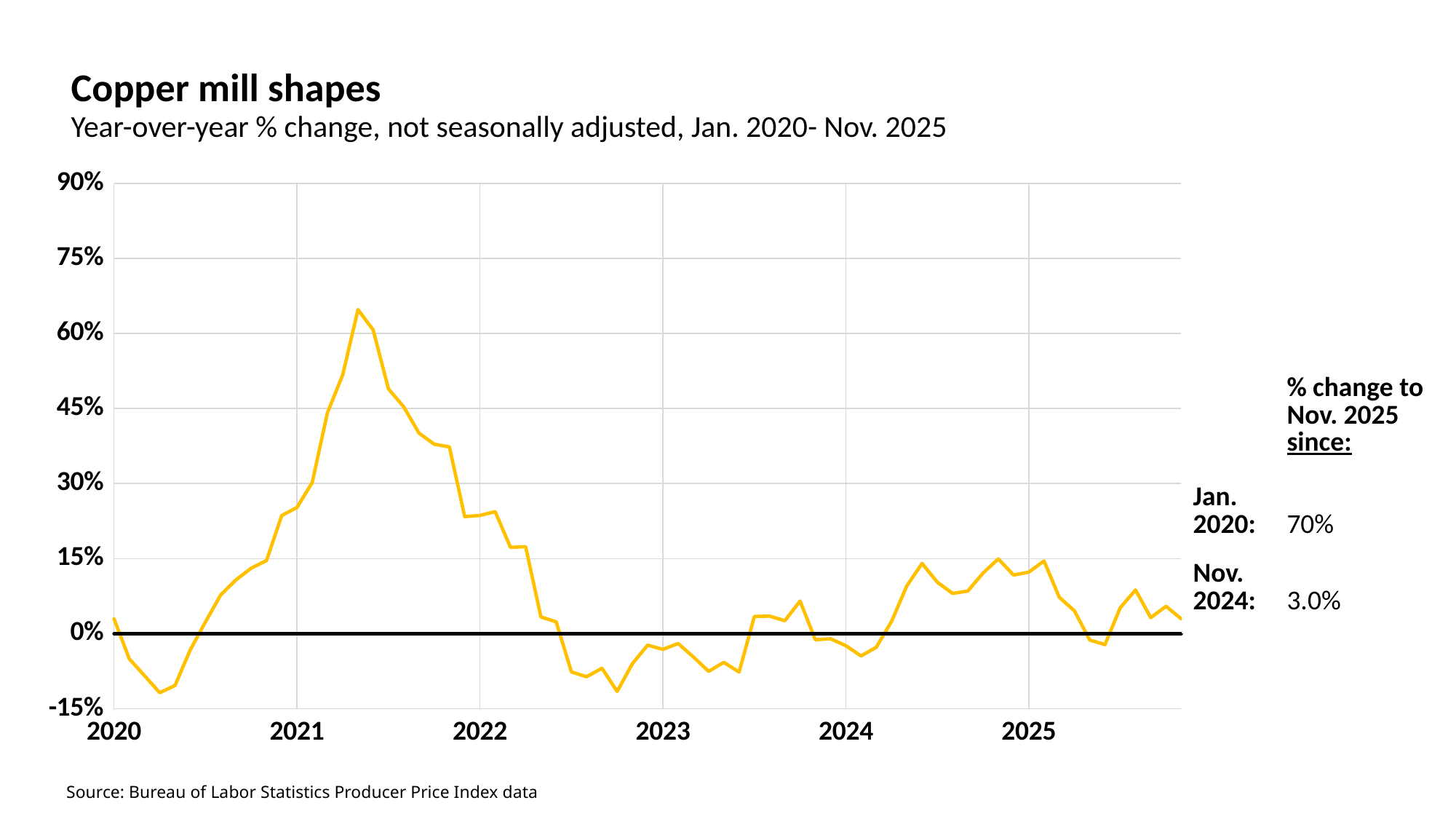
What kind of chart is shown on the slide? line chart According to the annotation, what is the % change to Nov. 2025 since Jan. 2020? 70% According to the annotation, what is the % change to Nov. 2025 since Nov. 2024? 3.0% What is the source cited for the chart data? Bureau of Labor Statistics Producer Price Index data Is the value at the start of 2022 greater or less than 15%? greater Is the peak value of the line in 2021 greater or less than 60%? greater In which year does the line reach its highest value? 2021 Is the value at the start of 2023 greater or less than 0%? less Does the line rise or fall between its 2021 peak and mid-2022? fall How many year labels are shown on the x axis? 6 What is the title of the chart? Copper mill shapes